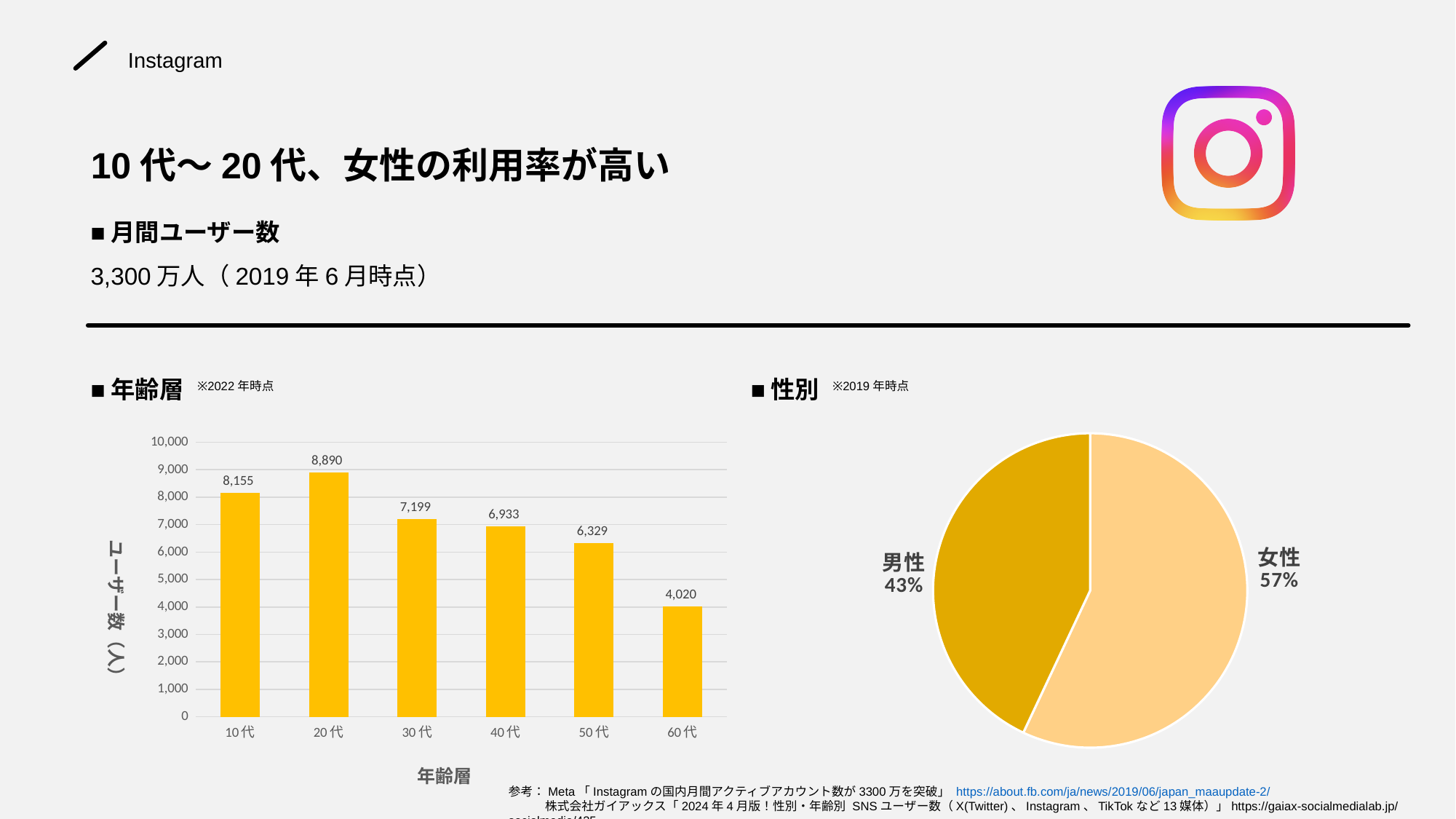
In the 年齢層 bar chart, how many age groups are shown? 6 What kind of chart is the 性別 chart? pie chart In the 性別 pie chart, what share is 女性? 57% In the 年齢層 bar chart, which age group has the lowest value? 60代 In the 年齢層 bar chart, do the values rise or fall from 20代 to 60代? fall In the 年齢層 bar chart, what is the value for 20代? 8,890 In the 性別 pie chart, what share is 男性? 43% In the 年齢層 bar chart, what is the difference between the values for 10代 and 20代? 735 In the 年齢層 bar chart, what is the value for 60代? 4,020 In the 年齢層 bar chart, which age group has the highest value? 20代 What kind of chart is the 年齢層 chart? bar chart In the 年齢層 bar chart, which is larger, the value for 30代 or 40代? 30代